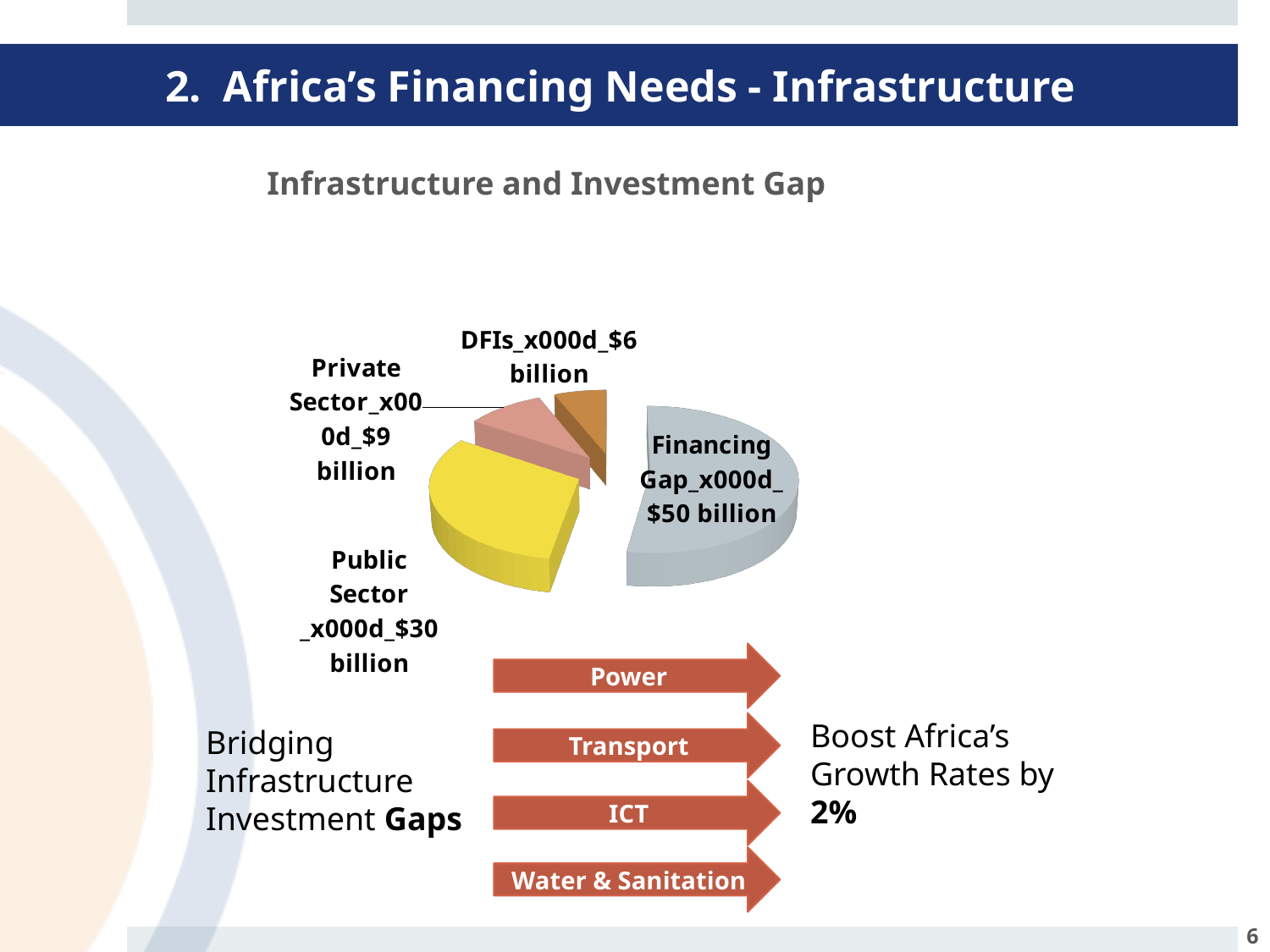
Which is larger in the pie chart, Private Sector or DFIs? Private Sector What is the title shown above the pie chart? Infrastructure and Investment Gap Which slice of the pie chart is the largest? Financing Gap What is the value of the Private Sector slice in the pie chart? $9 billion What kind of chart is shown on the slide? Pie chart How many slices does the pie chart have? 4 What is the value of the DFIs slice in the pie chart? $6 billion What is the total of all four slices in the pie chart? $95 billion What is the value of the Financing Gap slice in the pie chart? $50 billion What is the value of the Public Sector slice in the pie chart? $30 billion What is the difference between the Financing Gap and the Public Sector values in the pie chart? $20 billion Which slice of the pie chart is the smallest? DFIs